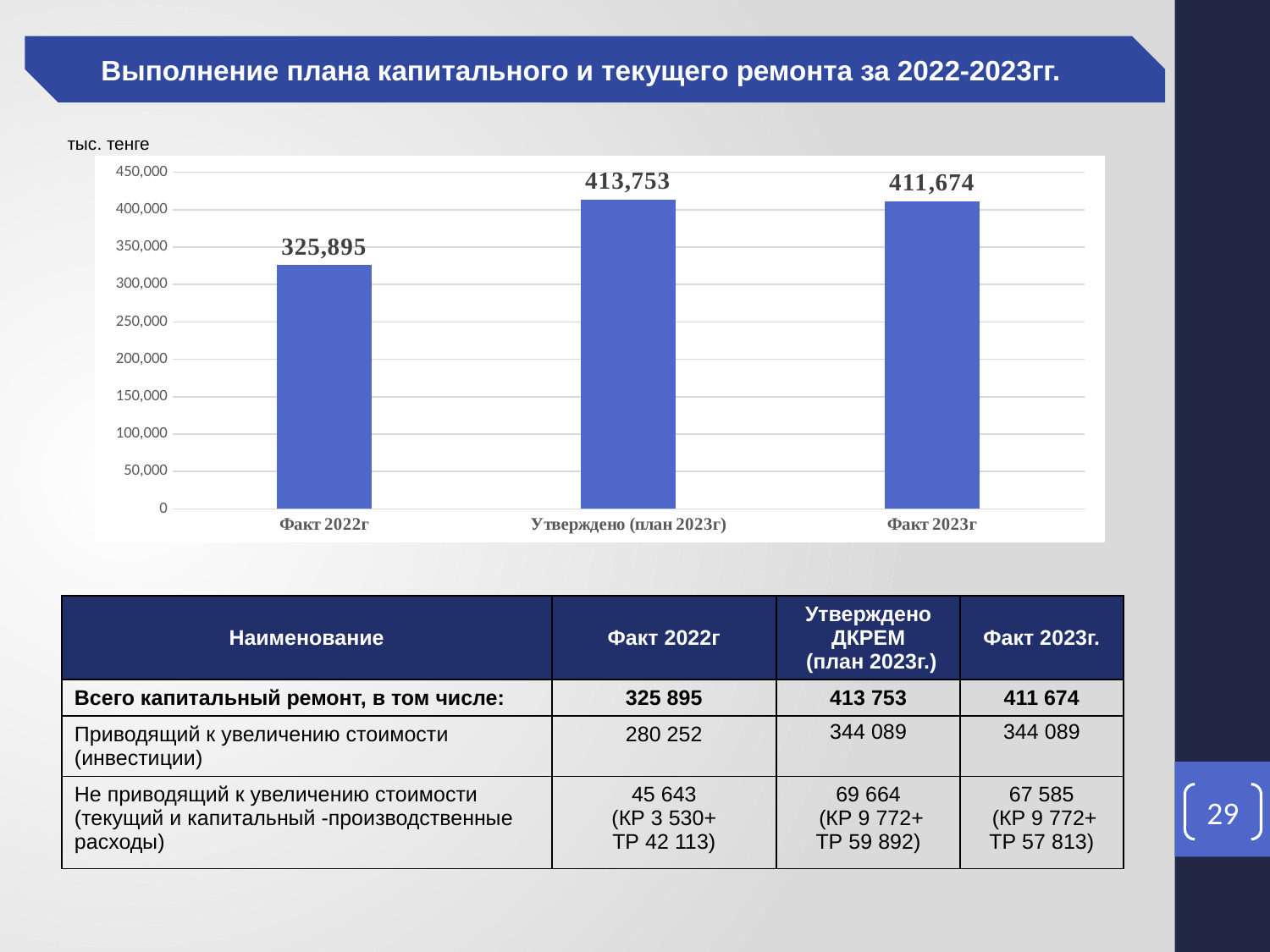
What is the difference between the values for Факт 2023г and Факт 2022г? 85,779 Is the value for Факт 2022г greater or less than 350,000? less What kind of chart is shown on the slide? bar chart What unit is indicated above the chart? тыс. тенге Which is larger, the value for Факт 2022г or the value for Факт 2023г? Факт 2023г What is the difference between the values for Утверждено (план 2023г) and Факт 2023г? 2,079 Which category has the highest value on the chart? Утверждено (план 2023г) What is the value for Утверждено (план 2023г) on the chart? 413,753 Which category has the lowest value on the chart? Факт 2022г What is the value for Факт 2022г on the chart? 325,895 What is the value for Факт 2023г on the chart? 411,674 How many bars are shown on the chart? 3